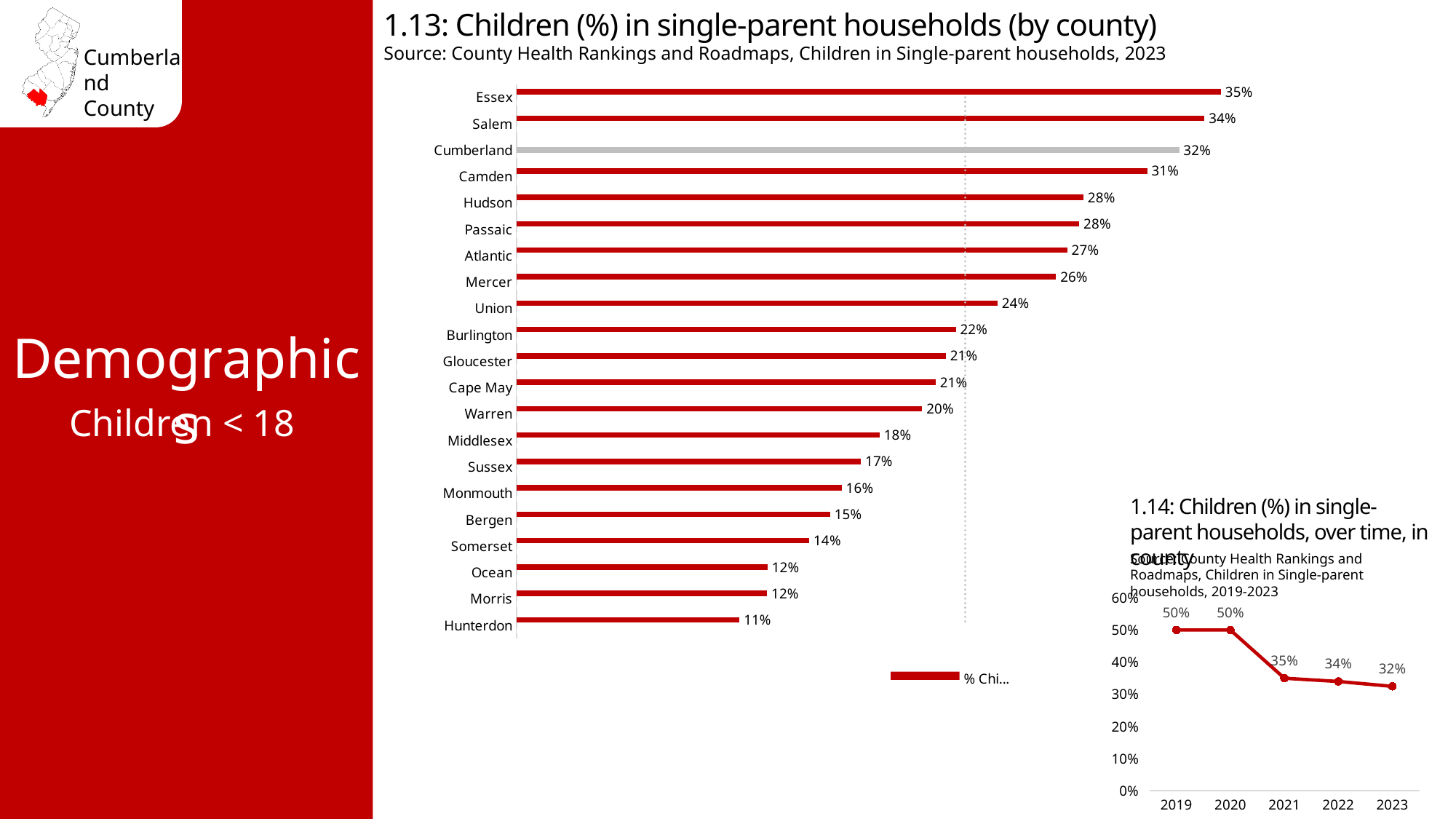
In chart 1.14 (over time, in county), do the values rise or fall from 2019 to 2023? Fall In chart 1.13 (Children (%) in single-parent households by county), what is the value for Cumberland? 32% What type of chart is chart 1.13 (Children (%) in single-parent households by county)? Bar chart In chart 1.14 (over time, in county), what is the difference between the values for 2020 and 2023? 18% In chart 1.13 (by county), which has a higher value, Camden or Union? Camden In chart 1.13 (by county), what is the value for Monmouth? 16% In chart 1.14 (over time, in county), what is the value for 2021? 35% In chart 1.13 (by county), how many counties are shown? 21 In chart 1.13 (by county), which county has the highest percentage of children in single-parent households? Essex In chart 1.13 (by county), which county has the lowest percentage of children in single-parent households? Hunterdon In chart 1.13 (by county), what is the difference between the values for Essex and Hunterdon? 24% In chart 1.14 (over time, in county), how many years are plotted? 5